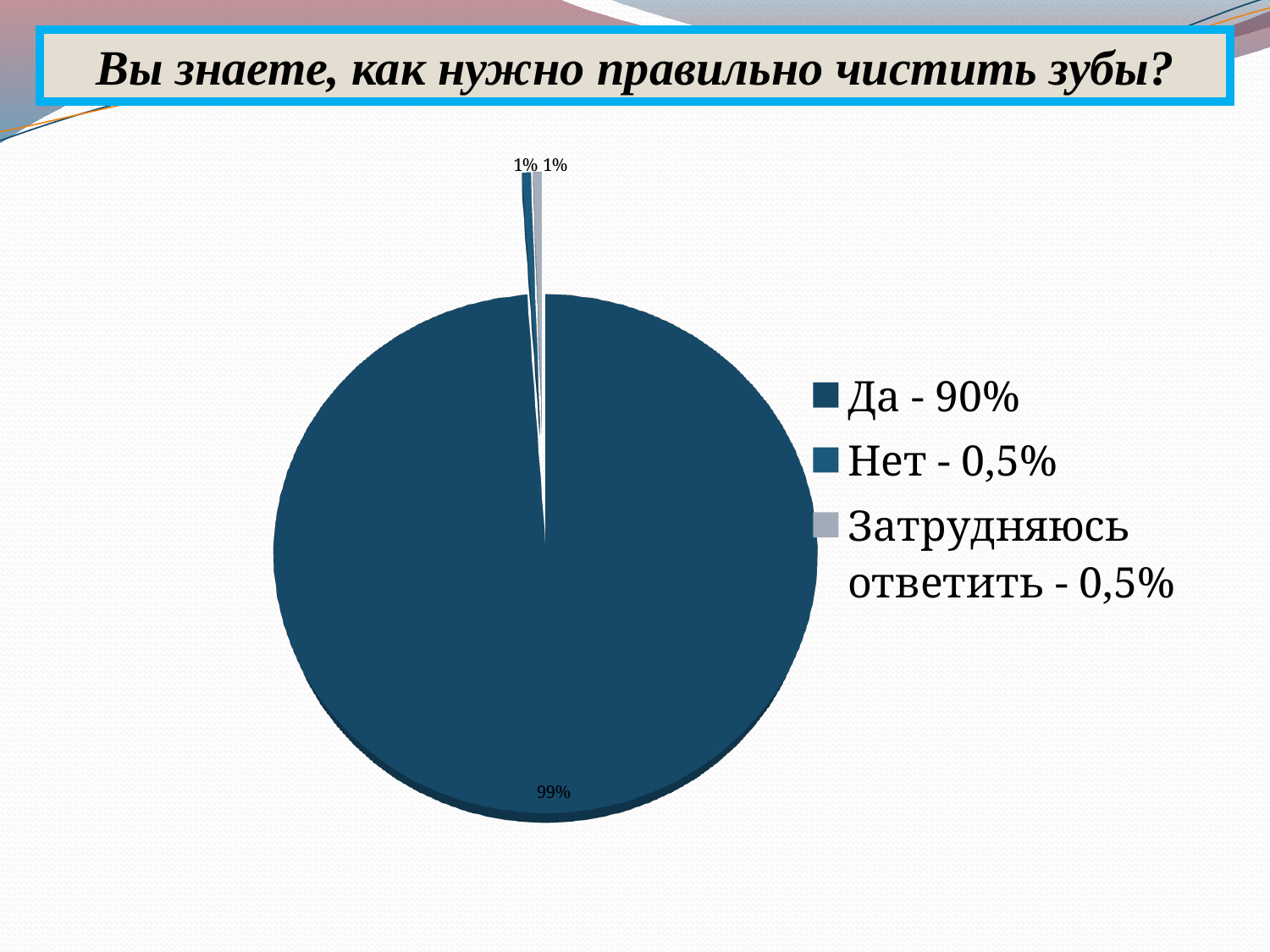
What is the title of the slide above the pie chart? Вы знаете, как нужно правильно чистить зубы? What data label is printed on the Нет slice of the pie chart? 1% Is the share of the Да slice greater or less than 50%? greater How many entries does the legend of the pie chart list? 3 What is the full legend entry for the first (largest) slice of the pie chart? Да - 90% Which category has the largest slice in the pie chart? Да What data label is printed on the largest slice of the pie chart? 99% What data label is printed on the Затрудняюсь ответить slice of the pie chart? 1% What kind of chart is shown on the slide? pie chart Which is larger in the pie chart, the Да slice or the Нет slice? Да How many slices does the pie chart have? 3